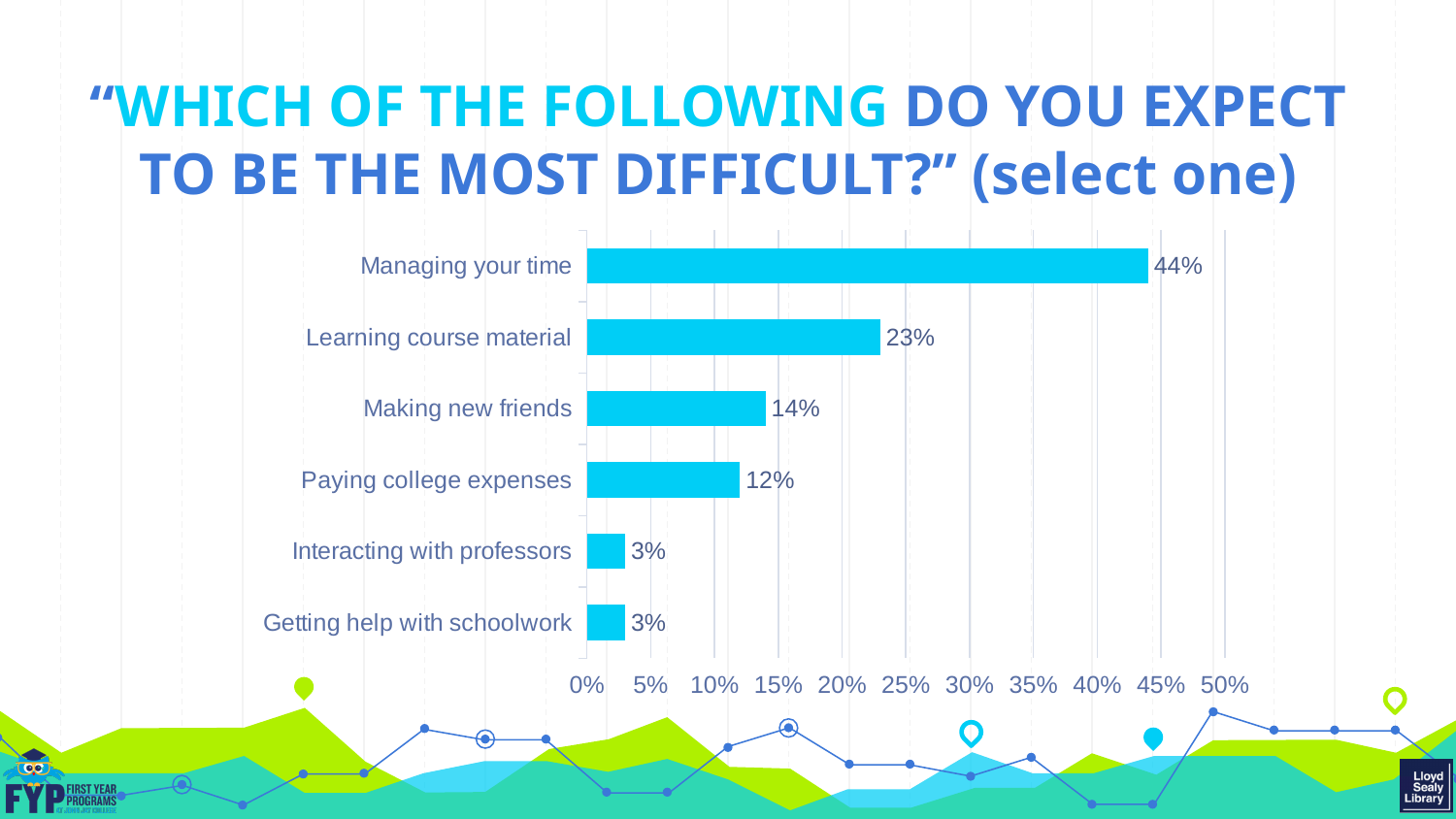
Is the value for Learning course material greater or less than 20%? greater Which category has the highest value? Managing your time What kind of chart is shown on the slide? Bar chart What is the highest value shown on the percentage axis? 50% What percentage of respondents expect managing your time to be the most difficult? 44% What is the difference between the values for Managing your time and Learning course material? 21% What is the value for Learning course material? 23% Which two categories share the lowest value of 3%? Interacting with professors and Getting help with schoolwork Which is larger, the value for Making new friends or the value for Paying college expenses? Making new friends What is the difference between the values for Making new friends and Paying college expenses? 2% How many categories are shown in the chart? 6 What is the value for Paying college expenses? 12%